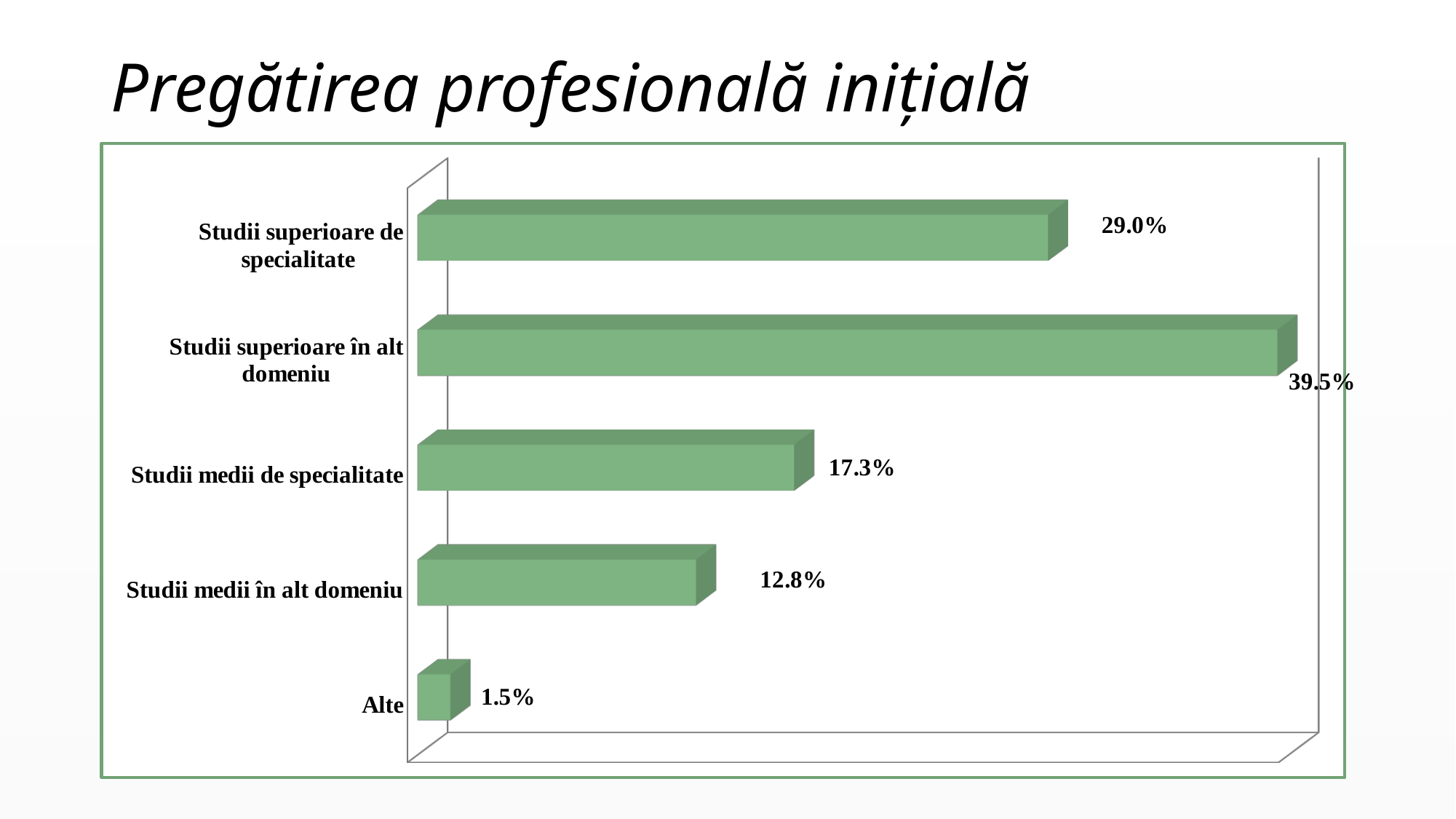
What is the title of the slide? Pregătirea profesională inițială What is the value for Studii medii în alt domeniu? 12.8% What is the value for Studii superioare în alt domeniu? 39.5% What is the value for Studii medii de specialitate? 17.3% What kind of chart is shown on the slide? Bar chart What is the value for Studii superioare de specialitate? 29.0% Which category has the lowest value? Alte What is the difference between Studii superioare în alt domeniu and Studii superioare de specialitate? 10.5% What is the value for Alte? 1.5% Which category has the highest value? Studii superioare în alt domeniu How many categories are shown in the chart? 5 Which is larger, Studii medii de specialitate or Studii medii în alt domeniu? Studii medii de specialitate